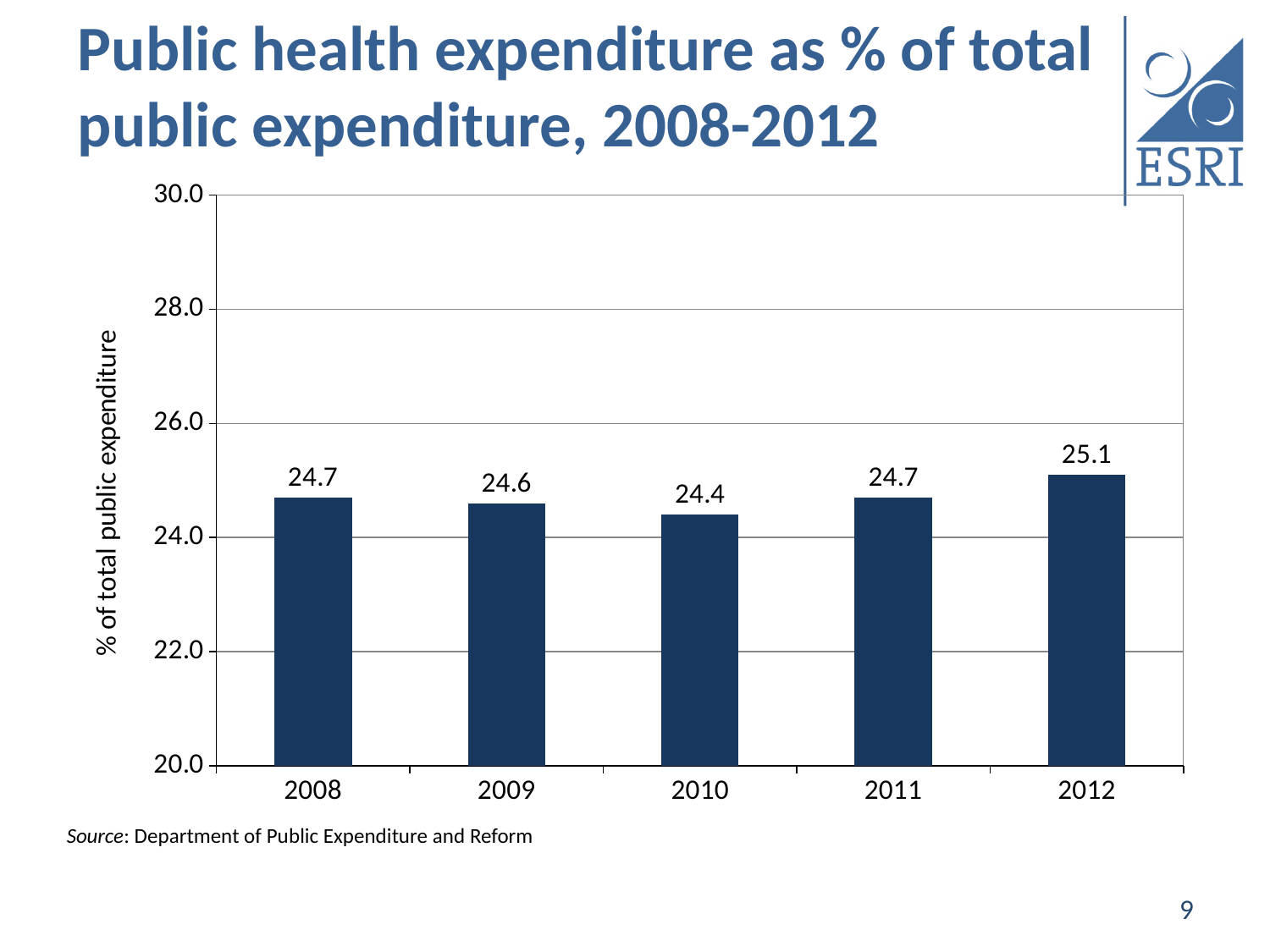
Do the values rise or fall from 2010 to 2012? rise Which is larger, the value for 2009 or the value for 2012? 2012 Which year has the lowest value? 2010 How many years are shown on the x axis? 5 Which year has the highest value? 2012 What is the difference between the values for 2012 and 2010? 0.7 Is the value for 2011 greater or less than 26.0? less What is the value for 2012? 25.1 What kind of chart is shown on the slide? bar chart What is the value for 2010? 24.4 What is the label of the y axis? % of total public expenditure What is the value for 2008? 24.7